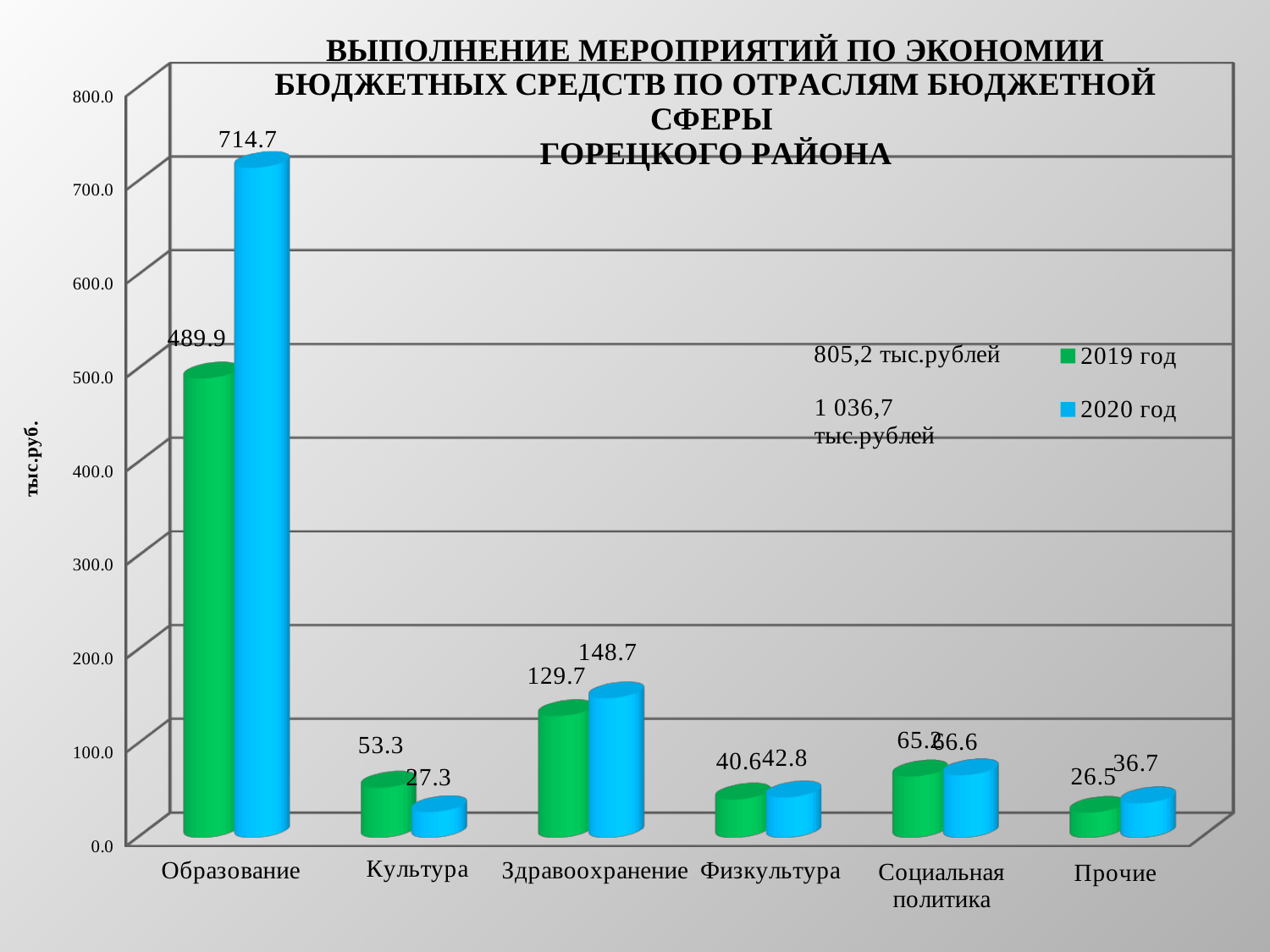
Which category has the lowest value for 2019 год? Прочие Is the value for Здравоохранение in 2020 год greater or less than 100.0? greater What is the value for Образование in 2020 год? 714.7 How many series does the legend list? 2 What is the difference between the 2020 год and 2019 год values for Здравоохранение? 19.0 What is the difference between the 2020 год and 2019 год values for Образование? 224.8 For Культура, which year has the larger value, 2019 год or 2020 год? 2019 год Which category has the highest value for 2020 год? Образование How many categories are shown on the x axis? 6 What is the value for Прочие in 2020 год? 36.7 What kind of chart is shown on the slide? bar chart What is the value for Культура in 2019 год? 53.3